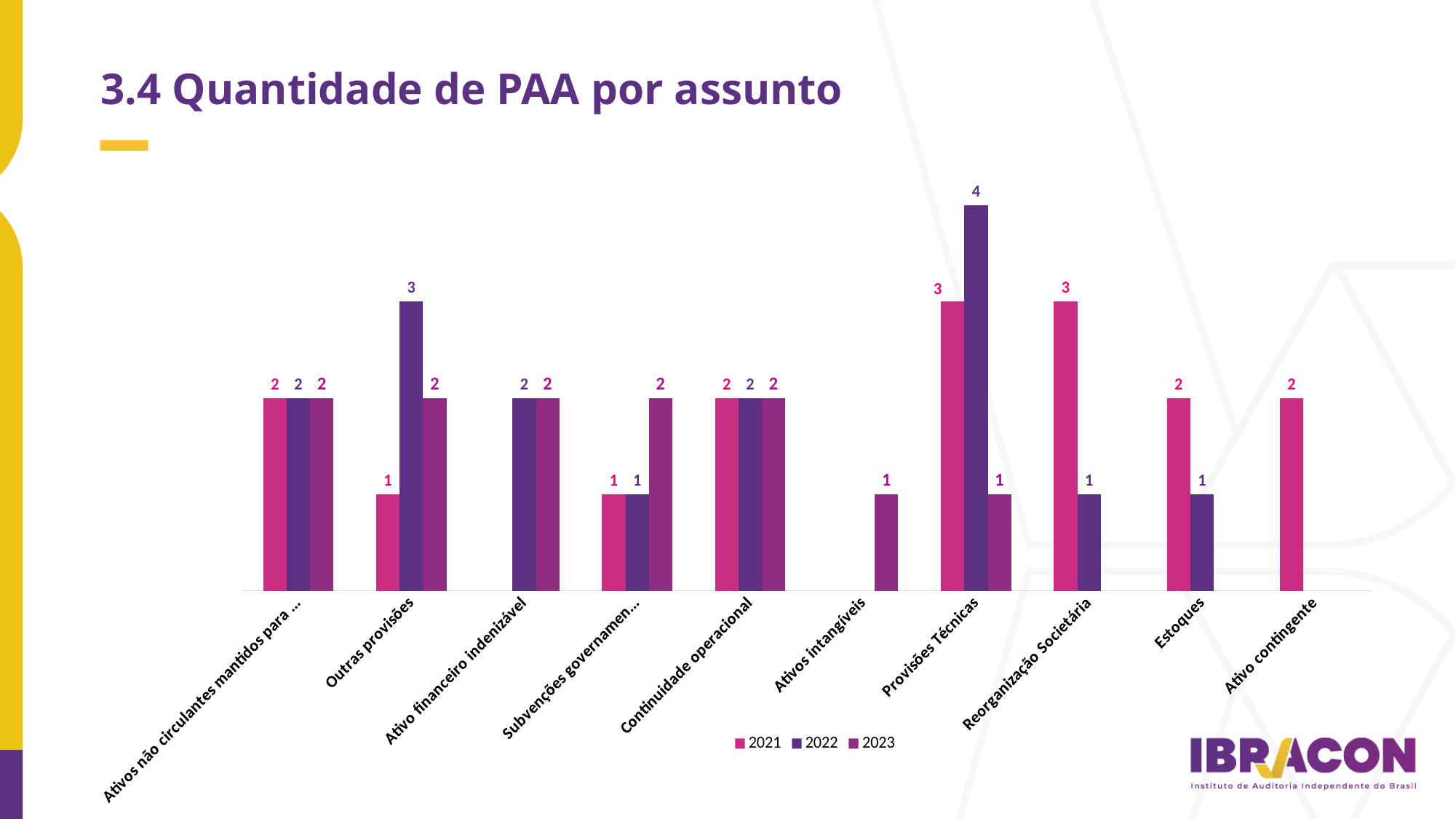
What is the value for 2023 in the Ativos intangíveis category? 1 What is the value for 2021 in the Reorganização Societária category? 3 Which category has the highest value for the 2022 series? Provisões Técnicas What is the title of the chart on the slide? 3.4 Quantidade de PAA por assunto What is the difference between the 2022 and 2023 values in the Provisões Técnicas category? 3 What is the difference between the 2021 and 2022 values in the Estoques category? 1 Which is larger in the Outras provisões category: the 2022 value or the 2023 value? 2022 How many series does the legend list? 3 What is the value for 2021 in the Outras provisões category? 1 How many categories are shown on the x axis? 10 What type of chart is shown on the slide? bar chart What is the value for 2022 in the Provisões Técnicas category? 4